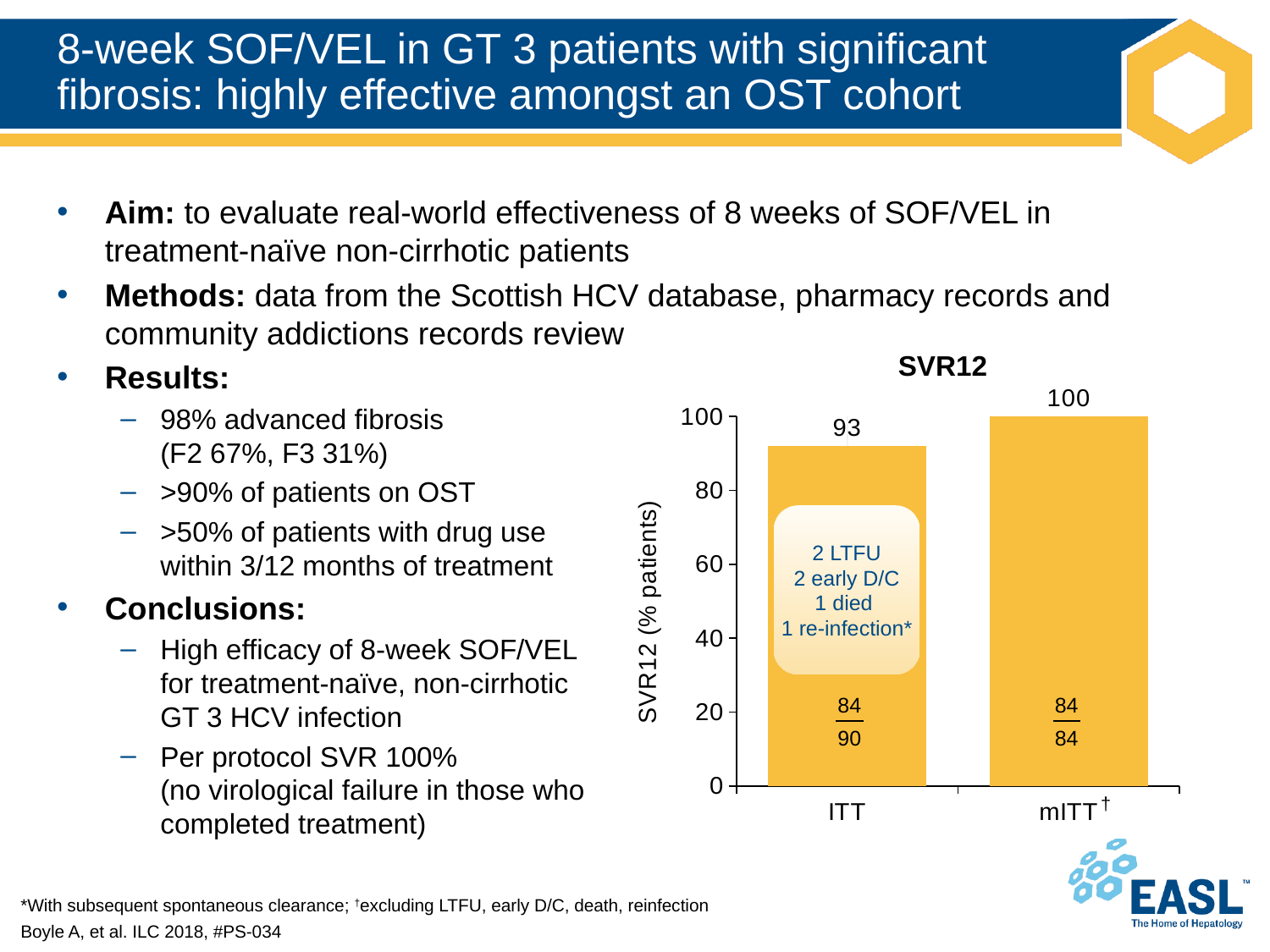
What is the SVR12 value for ITT? 93 What kind of chart is shown on the slide? bar chart What is the SVR12 value for mITT? 100 How many categories are shown on the x axis of the chart? 2 Is the SVR12 value for ITT greater or less than 80? greater What is the y-axis label of the chart? SVR12 (% patients) What is the difference between the SVR12 values for mITT and ITT? 7 What fraction is printed inside the ITT bar? 84/90 Which category has the higher SVR12 value, ITT or mITT? mITT What fraction is printed inside the mITT bar? 84/84 What is the title of the chart? SVR12 Which category has the lowest SVR12 value? ITT